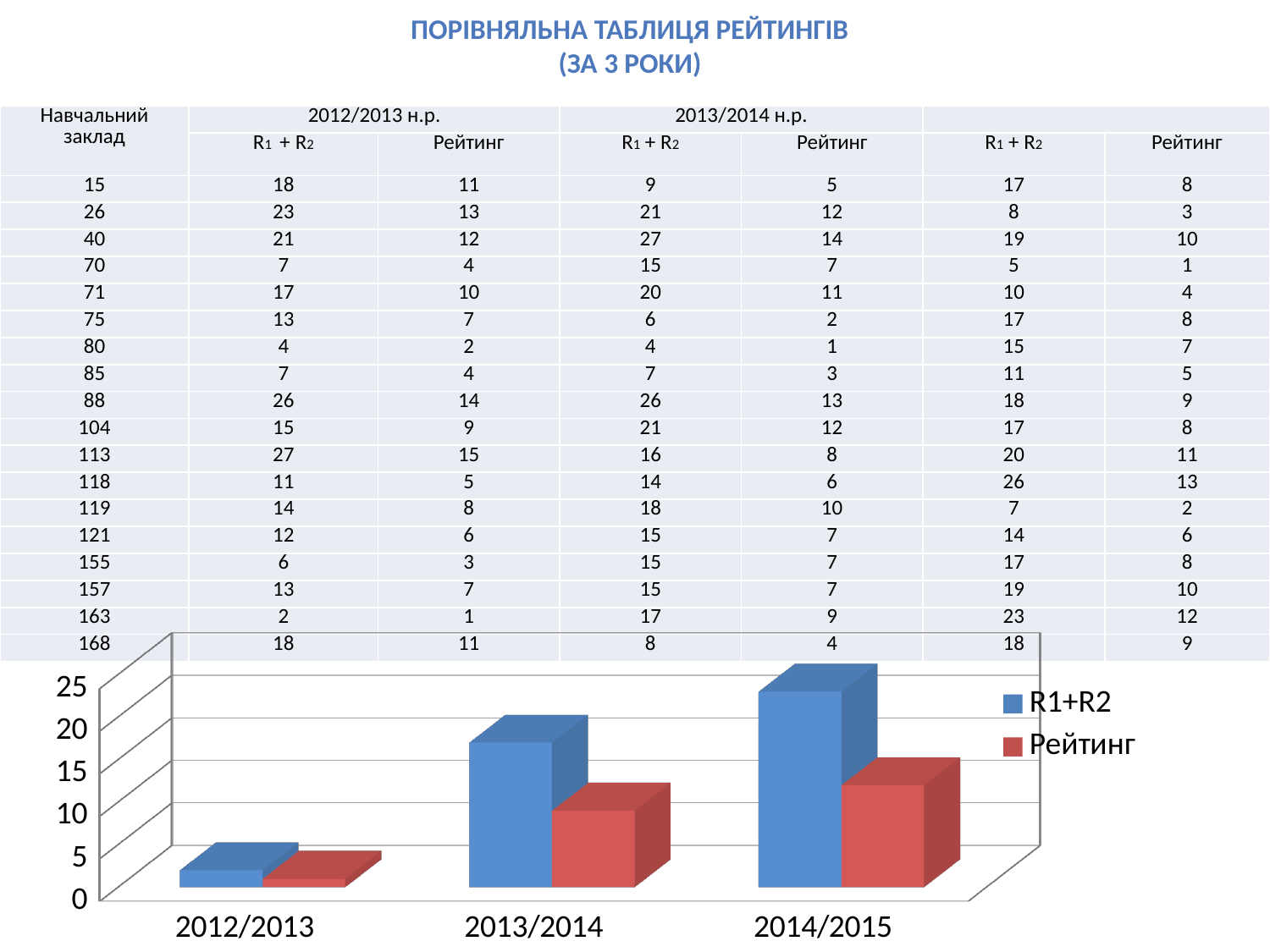
What kind of chart is shown at the bottom of the slide? bar chart In the chart, is the Рейтинг value for 2014/2015 greater or less than 10? greater In the chart, is the R1+R2 value for 2013/2014 greater or less than 15? greater In the chart, is the R1+R2 value for 2014/2015 greater or less than 20? greater What colour are the R1+R2 bars in the chart? blue How many series does the chart legend list? 2 Which category has the lowest Рейтинг bar in the chart? 2012/2013 Do the R1+R2 values in the chart rise or fall from 2012/2013 to 2014/2015? rise In the chart, which is larger for 2013/2014: R1+R2 or Рейтинг? R1+R2 How many categories are shown on the x axis of the chart? 3 Which category has the highest R1+R2 bar in the chart? 2014/2015